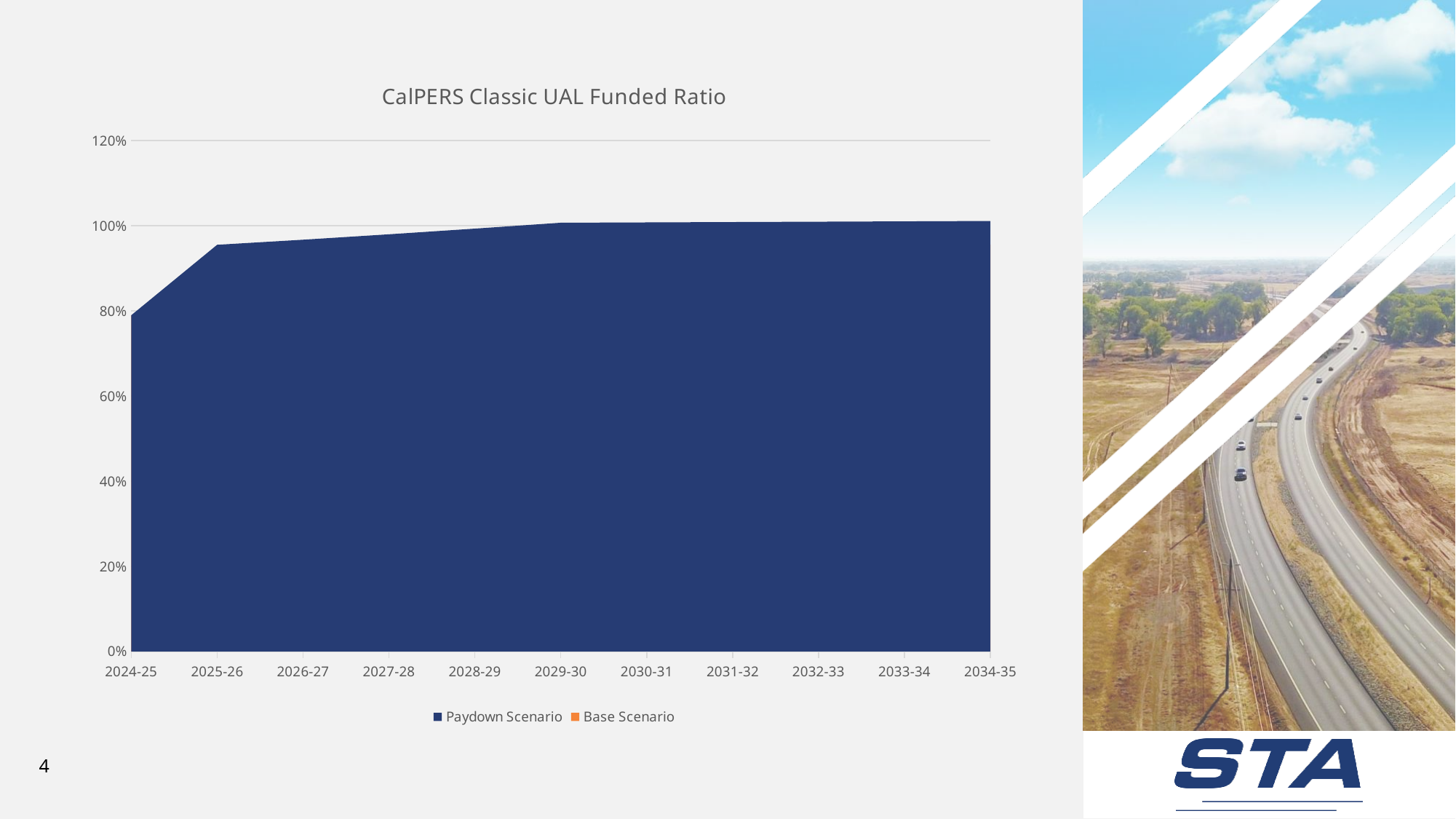
How many fiscal years are shown on the x axis? 11 Do the Paydown Scenario values rise or fall from 2024-25 to 2034-35? rise Which fiscal year has the lowest Paydown Scenario funded ratio? 2024-25 What is the title of the chart? CalPERS Classic UAL Funded Ratio Is the Paydown Scenario value for 2034-35 greater or less than 120%? less Is the Paydown Scenario value for 2027-28 greater or less than 60%? greater What kind of chart is shown on the slide? area chart Is the Paydown Scenario value for 2025-26 greater or less than 80%? greater Which two series are listed in the legend? Paydown Scenario and Base Scenario Which is larger, the Paydown Scenario value for 2024-25 or for 2025-26? 2025-26 How many series does the legend list? 2